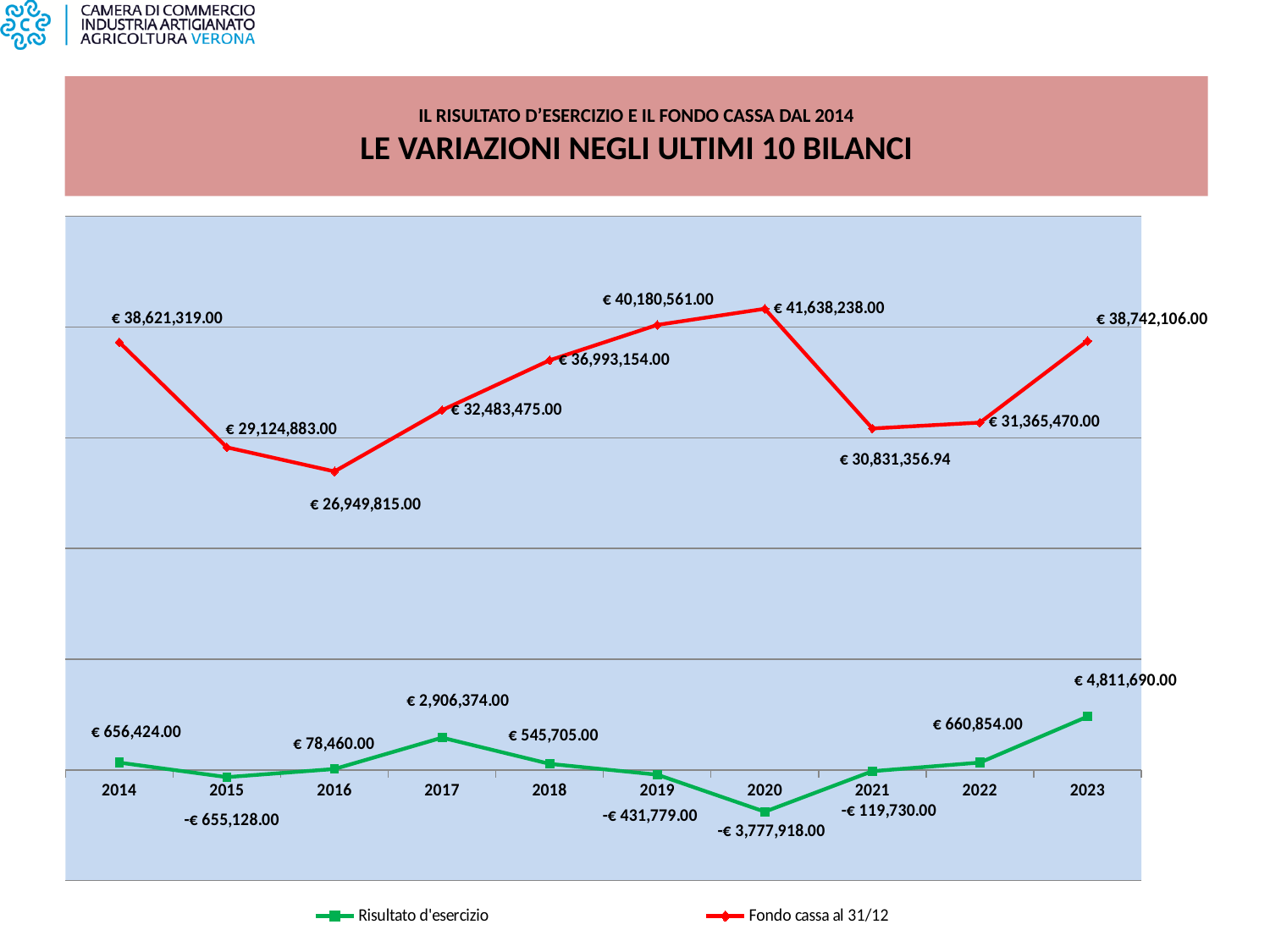
What kind of chart is shown on the slide? Line chart What is the difference between Fondo cassa al 31/12 in 2020 and in 2016? € 14,688,423.00 In which year is Risultato d'esercizio highest? 2023 In which year is Fondo cassa al 31/12 lowest? 2016 Which is larger, Fondo cassa al 31/12 in 2014 or in 2023? 2023 In which year is Fondo cassa al 31/12 highest? 2020 What is the value of Fondo cassa al 31/12 for 2021? € 30,831,356.94 How many years are shown on the x axis? 10 What is the value of Risultato d'esercizio for 2020? -€ 3,777,918.00 What is the value of Risultato d'esercizio for 2017? € 2,906,374.00 What is the value of Fondo cassa al 31/12 for 2020? € 41,638,238.00 How many series does the legend list? 2